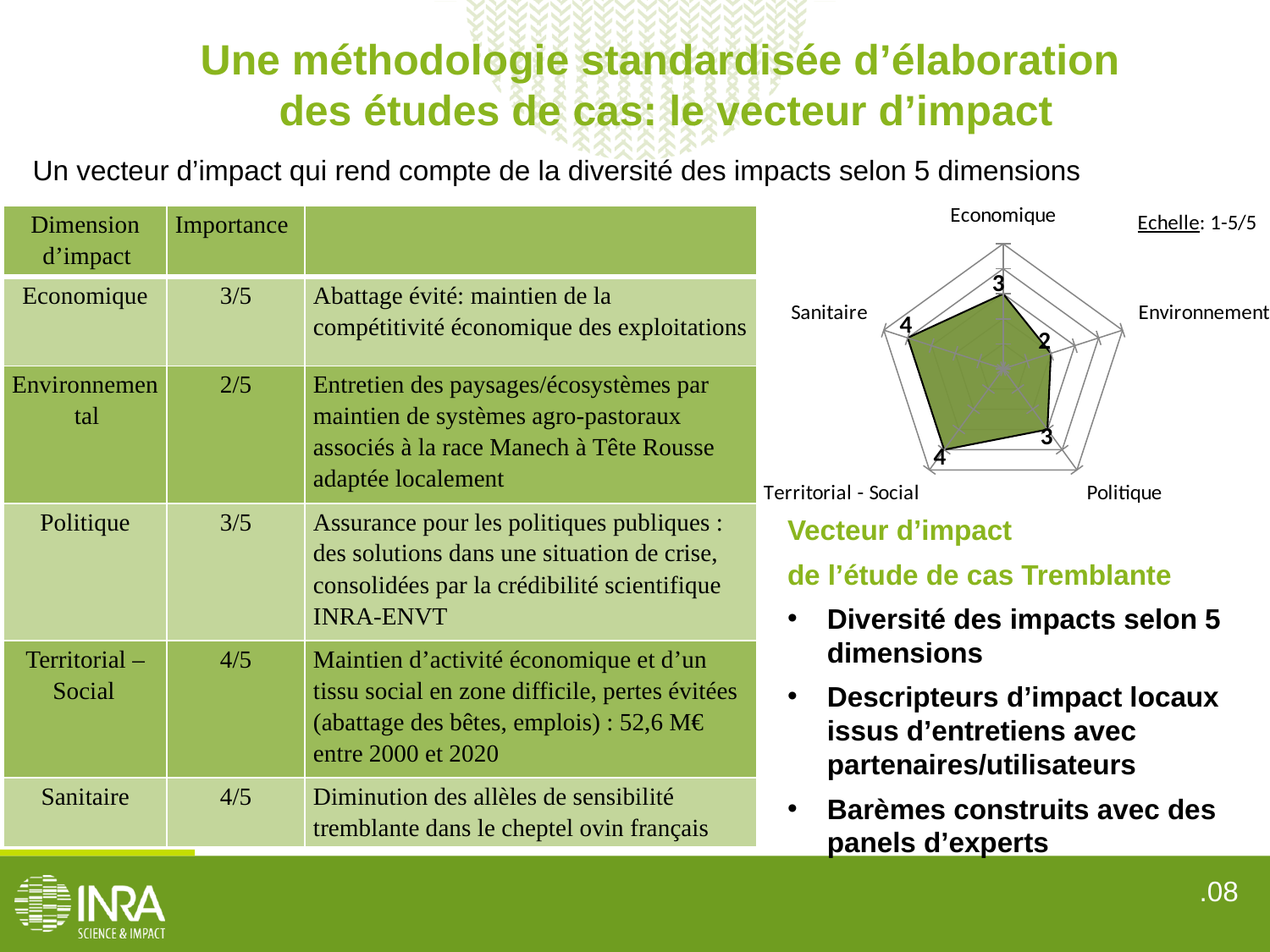
In the radar chart, what is the value for Territorial - Social? 4 In the radar chart, what is the value for Environnement? 2 In the radar chart, which is larger, the value for Territorial - Social or the value for Economique? Territorial - Social In the radar chart, what is the value for Politique? 3 In the radar chart, what is the difference between the values for Sanitaire and Environnement? 2 In the radar chart, which dimension has the lowest value? Environnement In the radar chart, what is the total of the five dimension values? 16 In the radar chart, what is the value for Sanitaire? 4 What kind of chart is shown on the right of the slide? radar chart What scale (Echelle) is indicated for the radar chart? 1-5/5 In the radar chart, what is the value for Economique? 3 How many dimensions (axes) does the radar chart have? 5